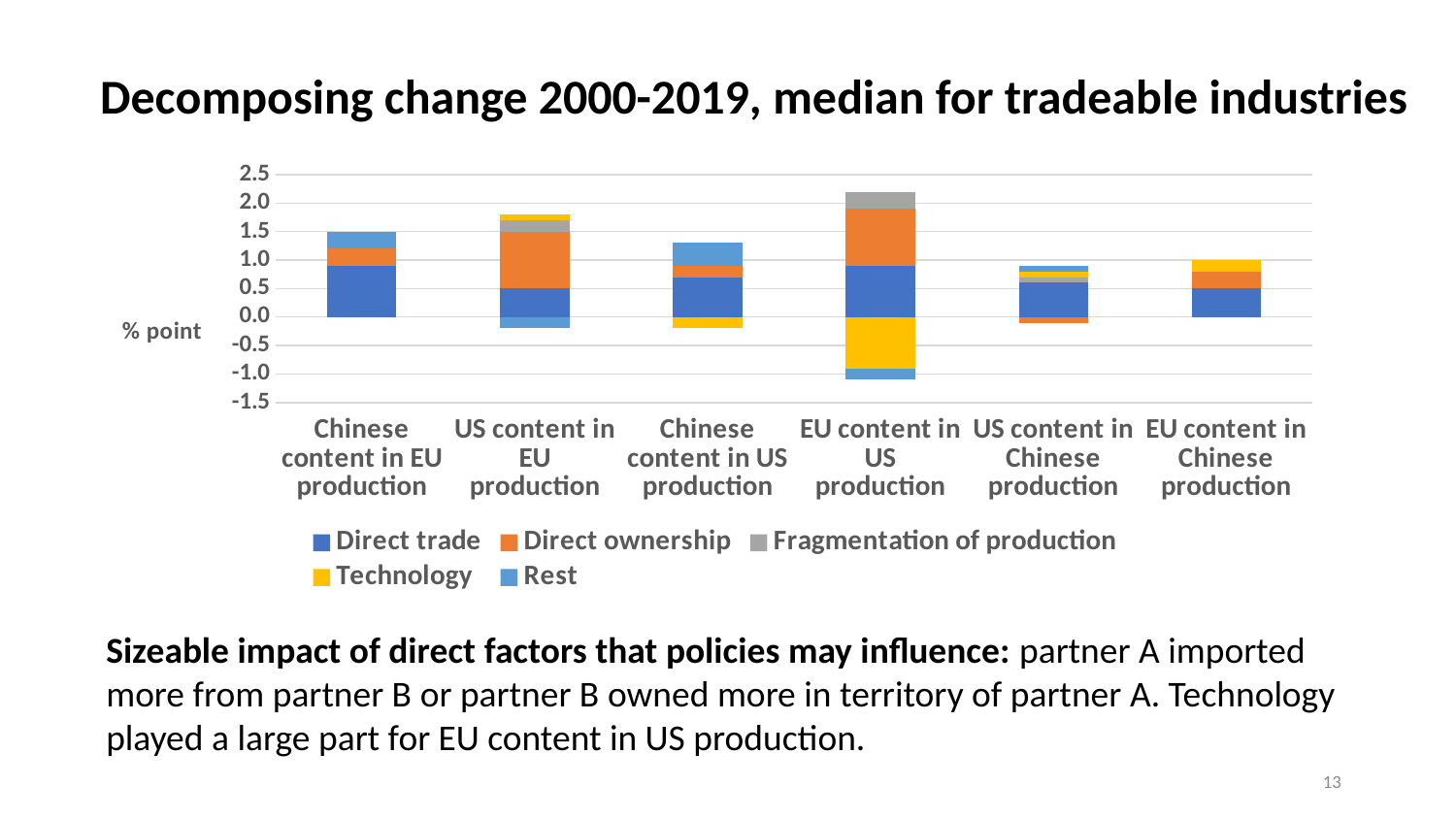
How many series does the chart's legend list? 5 Which has the larger Direct ownership segment: US content in EU production or Chinese content in EU production? US content in EU production How many categories are shown along the x axis of the chart? 6 Is the Technology value for EU content in US production greater or less than -0.5? less What is the title of the chart? Decomposing change 2000-2019, median for tradeable industries What kind of chart is shown on the slide? Stacked bar chart What label is shown on the vertical axis of the chart? % point Which category has the largest negative (below zero) portion of its bar? EU content in US production Which has the larger Technology segment in absolute size: EU content in US production or EU content in Chinese production? EU content in US production Is the Direct ownership value for US content in EU production greater or less than 0.5? greater Is the Direct trade value for Chinese content in EU production greater or less than 0.5? greater Which category has the tallest positive stacked bar? EU content in US production